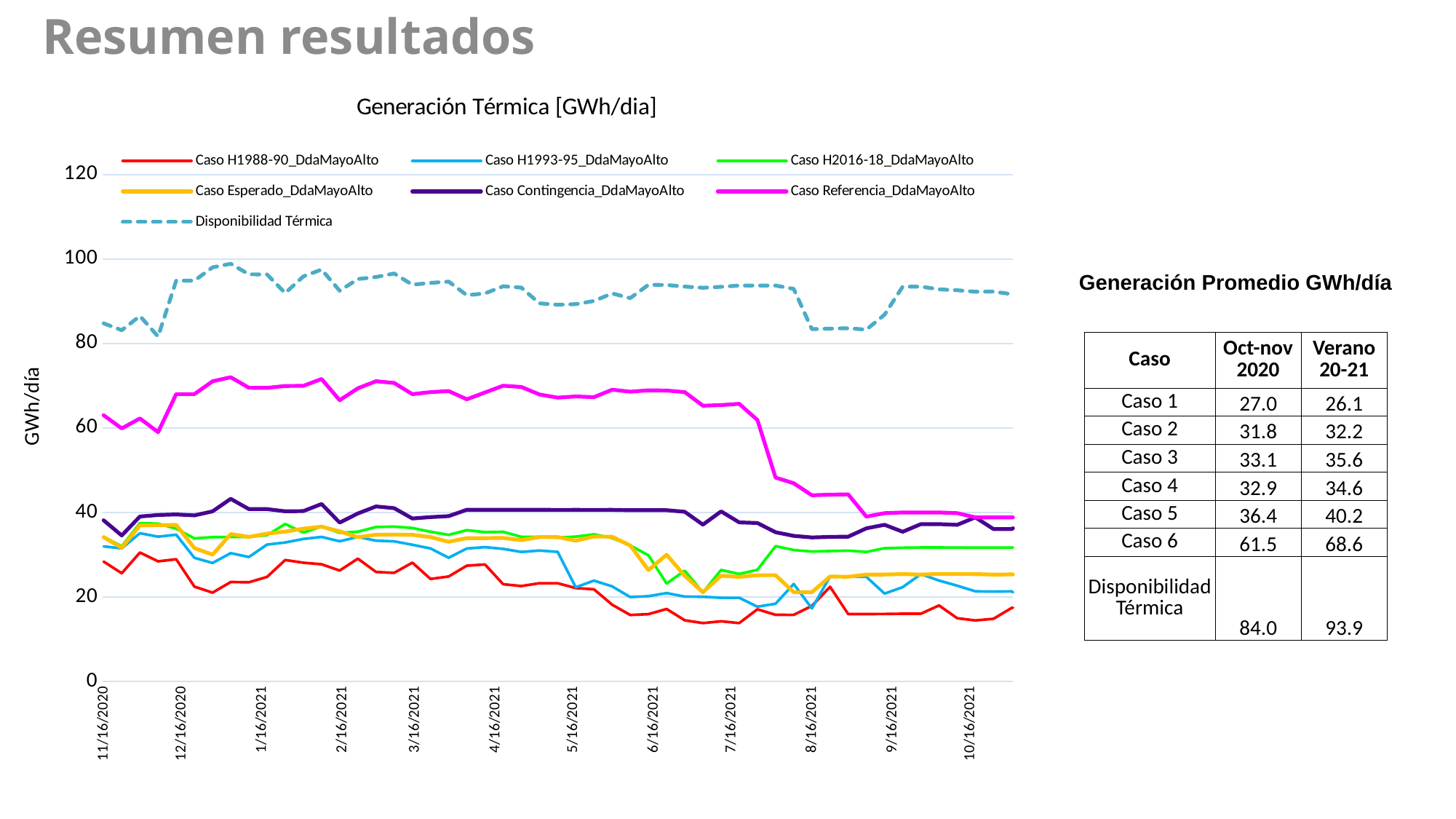
In the 'Generación Térmica [GWh/dia]' chart, is the value of Caso H1988-90_DdaMayoAlto at 7/16/2021 greater or less than 20? less What kind of chart is 'Generación Térmica [GWh/dia]'? line chart In the 'Generación Térmica [GWh/dia]' chart, does Caso Referencia_DdaMayoAlto rise or fall between 7/16/2021 and 9/16/2021? fall What is the y-axis title of the 'Generación Térmica [GWh/dia]' chart? GWh/día In the 'Generación Térmica [GWh/dia]' chart, is the value of Disponibilidad Térmica at 1/16/2021 greater or less than 80? greater How many series does the legend of the 'Generación Térmica [GWh/dia]' chart list? 7 In the 'Generación Térmica [GWh/dia]' chart, which series has the lowest values for most of the period? Caso H1988-90_DdaMayoAlto In the 'Generación Térmica [GWh/dia]' chart, is the value of Caso Contingencia_DdaMayoAlto at 1/16/2021 greater or less than 20? greater In the 'Generación Térmica [GWh/dia]' chart, which series is drawn with a dashed line? Disponibilidad Térmica In the 'Generación Térmica [GWh/dia]' chart, which series has the highest values across the whole period? Disponibilidad Térmica In the 'Generación Térmica [GWh/dia]' chart, at 3/16/2021, which is larger: Caso Referencia_DdaMayoAlto or Caso Contingencia_DdaMayoAlto? Caso Referencia_DdaMayoAlto